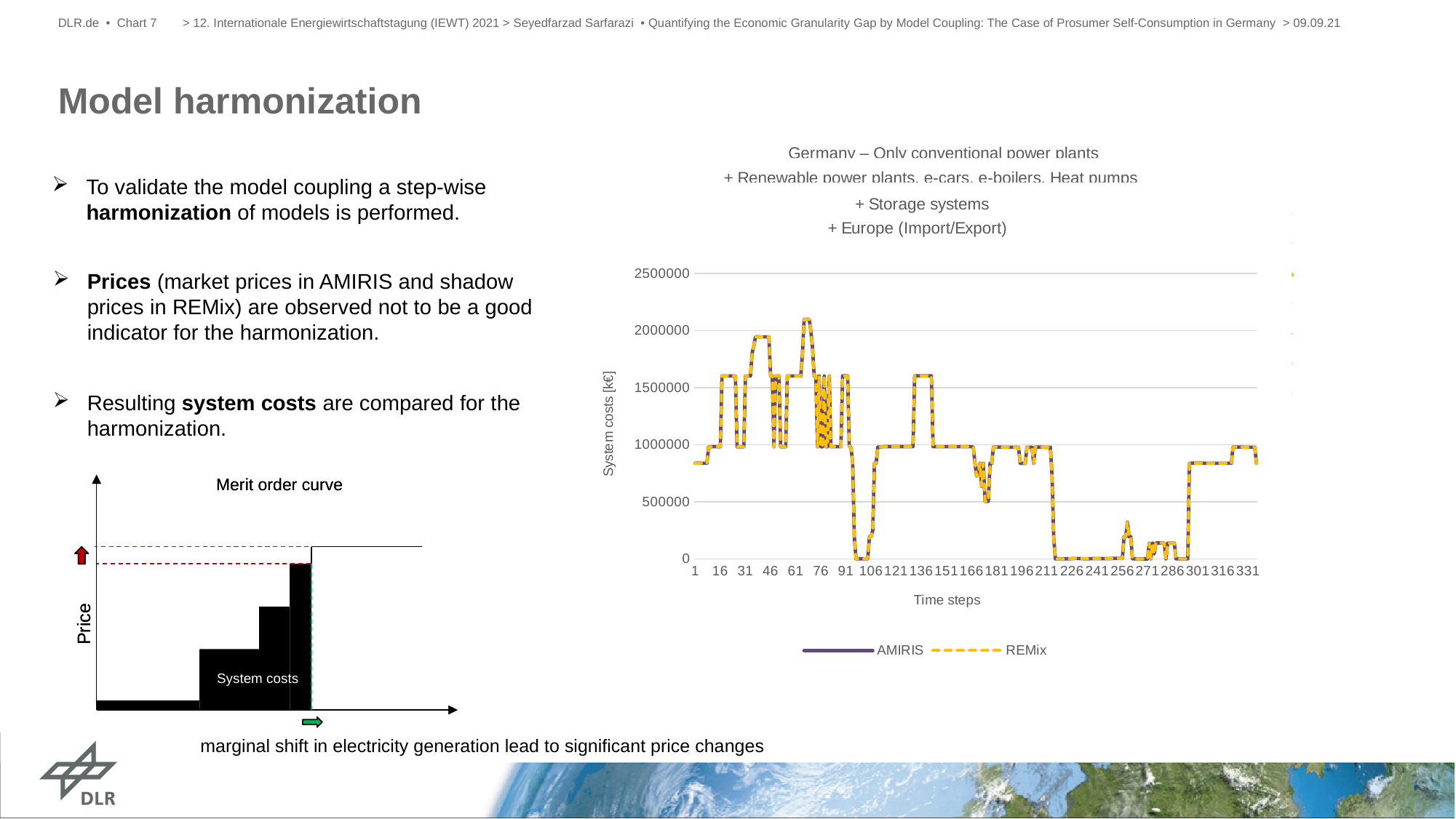
In the system costs chart, is the value at time step 136 greater or less than 1000000? greater In the system costs chart, is the value at time step 301 greater or less than 1000000? less In the system costs chart, is the value at time step 226 greater or less than 500000? less What kind of chart is shown on the right side of the slide? line chart What are the two series named in the legend of the system costs chart? AMIRIS and REMix How many series does the legend of the system costs chart list? 2 What is the label of the y axis of the system costs chart? System costs [k€]